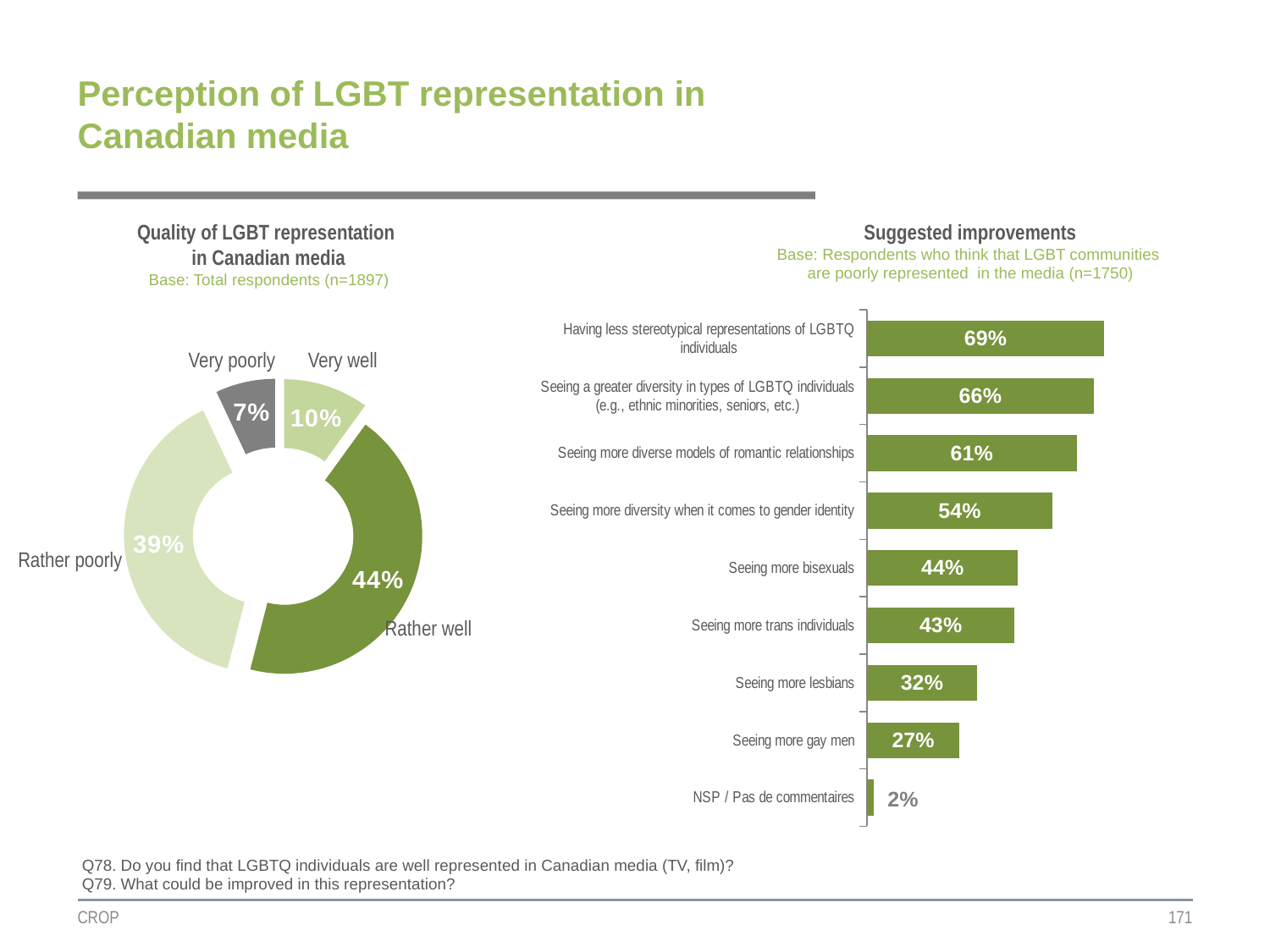
In the 'Suggested improvements' chart, which improvement has the highest value? Having less stereotypical representations of LGBTQ individuals In the 'Quality of LGBT representation in Canadian media' chart, what is the difference between the 'Rather well' and 'Rather poorly' shares? 5% In the 'Suggested improvements' chart, what is the value for 'Seeing more gay men'? 27% In the 'Quality of LGBT representation in Canadian media' chart, what share of respondents answered 'Very poorly'? 7% In the 'Suggested improvements' chart, how many categories are shown? 9 In the 'Suggested improvements' chart, what is the difference between 'Seeing more bisexuals' and 'Seeing more lesbians'? 12% What kind of chart is the 'Quality of LGBT representation in Canadian media' chart? Doughnut chart What kind of chart is the 'Suggested improvements' chart? Bar chart In the 'Quality of LGBT representation in Canadian media' chart, what share of respondents answered 'Rather well'? 44% In the 'Quality of LGBT representation in Canadian media' chart, which response has the largest share? Rather well In the 'Suggested improvements' chart, what is the value for 'Seeing more diverse models of romantic relationships'? 61% In the 'Quality of LGBT representation in Canadian media' chart, which response has the smallest share? Very poorly